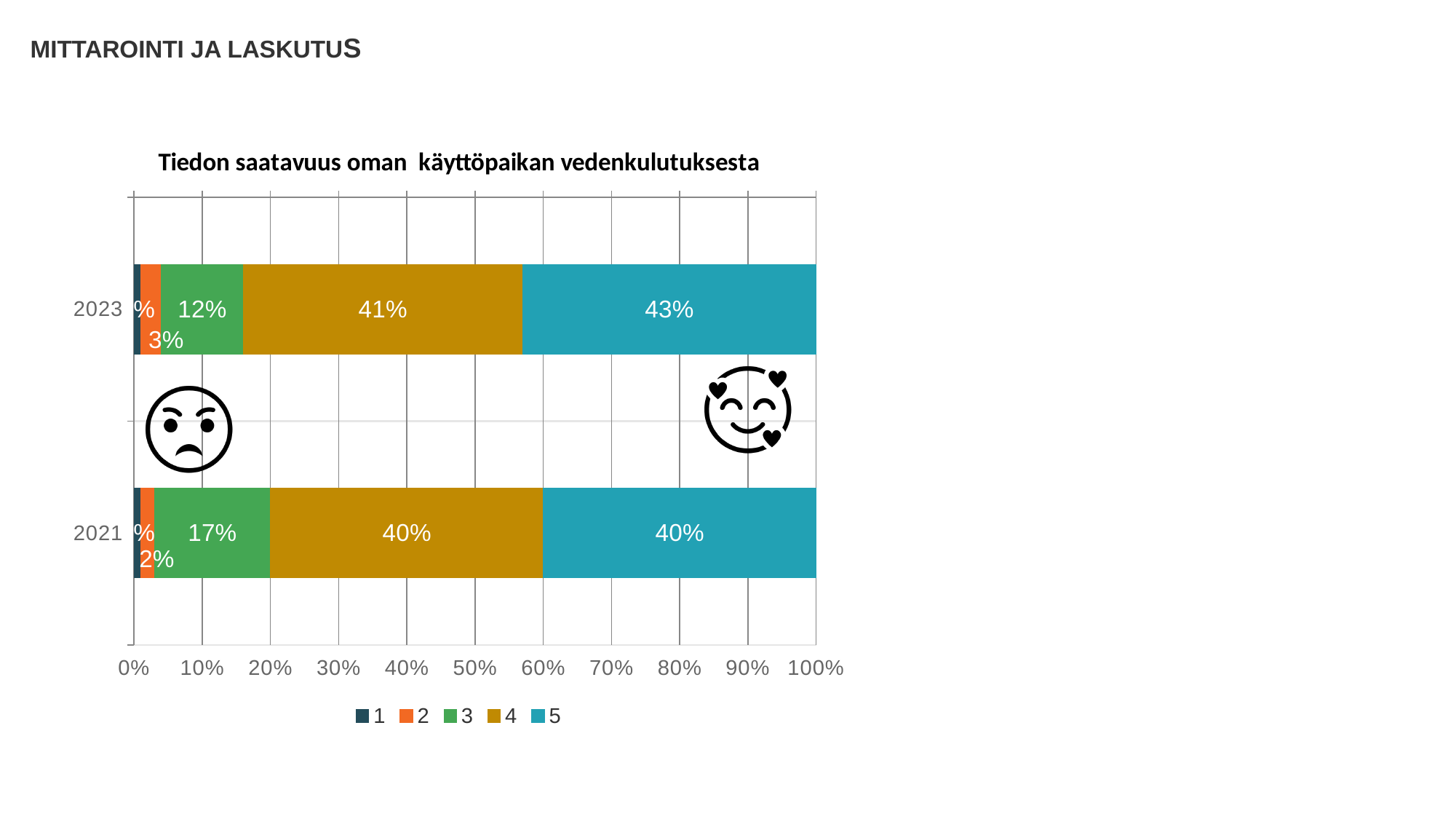
How many categories (years) are shown on the chart? 2 What is the difference between the series 5 values for 2023 and 2021? 3 percentage points What type of chart is shown on the slide? stacked bar chart What is the value for series 2 in 2021? 2% How many series does the legend list? 5 What is the value for series 5 in 2023? 43% What is the value for series 3 in 2023? 12% Which year has the larger value for series 3, 2023 or 2021? 2021 What is the value for series 4 in 2021? 40% What is the title of the chart? Tiedon saatavuus oman käyttöpaikan vedenkulutuksesta Which series has the largest share in the 2023 bar? 5 Is the value for series 4 in 2023 greater or less than 30%? greater